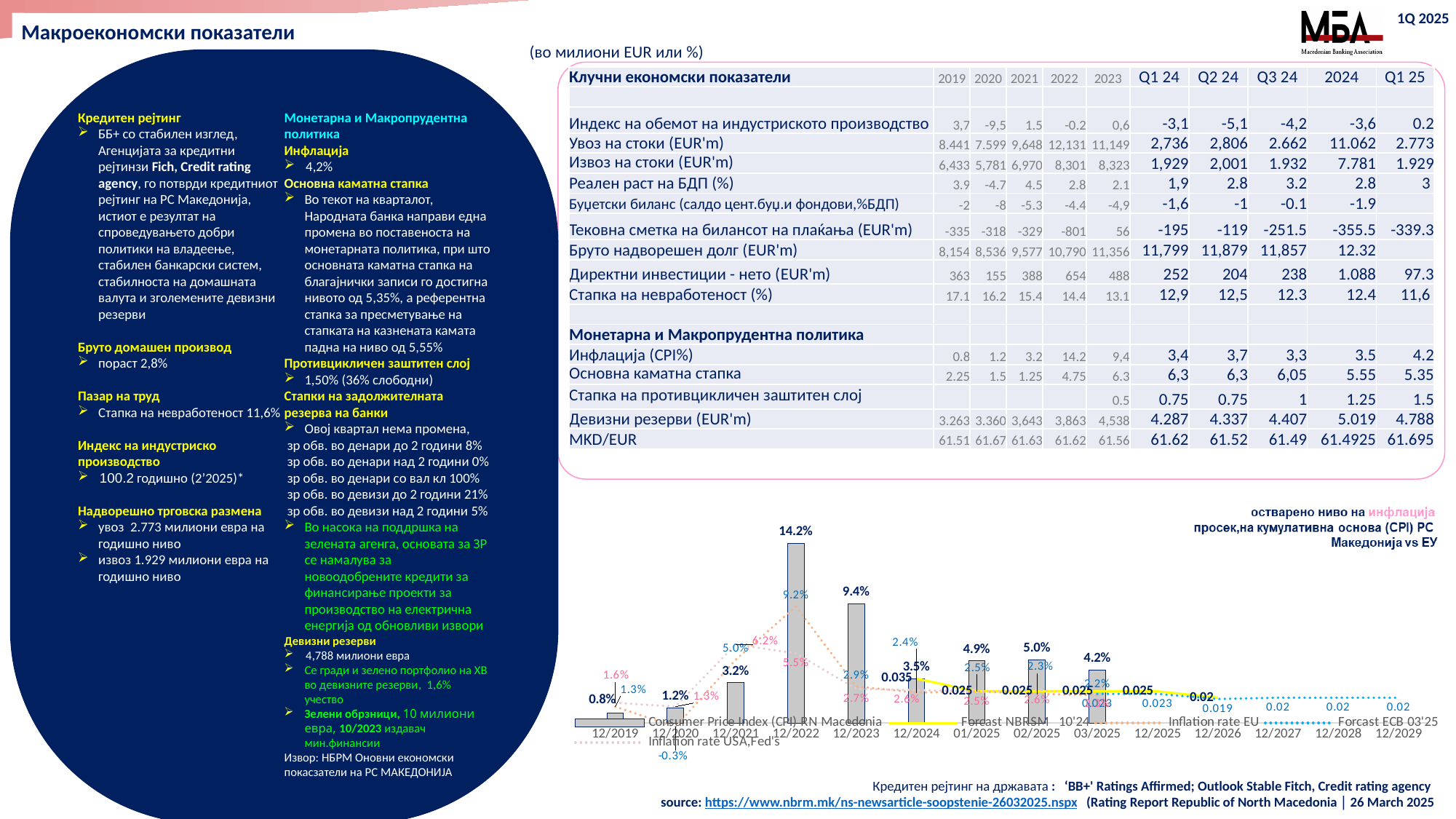
In the inflation chart at the bottom of the slide, which is larger, the CPI value for 01/2025 or for 02/2025? 02/2025 In the inflation chart at the bottom of the slide, what is the CPI value for RN Macedonia shown for 12/2023? 9.4% In the inflation chart at the bottom of the slide, what is the difference between the CPI values for 12/2022 and 12/2023? 4.8% In the inflation chart at the bottom of the slide, do the CPI bars for RN Macedonia rise or fall from 12/2022 to 12/2024? fall In the inflation chart at the bottom of the slide, what is the CPI value for RN Macedonia shown for 12/2022? 14.2% In the inflation chart at the bottom of the slide, what is the Forcast NBRSM 10'24 value shown for 12/2026? 0.02 In the inflation chart at the bottom of the slide, what is the CPI value for RN Macedonia shown for 03/2025? 4.2% In the inflation chart at the bottom of the slide, how many series does the legend list? 5 In the inflation chart at the bottom of the slide, which period has the highest CPI bar for RN Macedonia? 12/2022 In the inflation chart at the bottom of the slide, which period has the lowest CPI bar for RN Macedonia? 12/2019 In the inflation chart at the bottom of the slide, what is the CPI value for RN Macedonia shown for 12/2019? 0.8% In the inflation chart at the bottom of the slide, what is the difference between the CPI values for 02/2025 and 03/2025? 0.8%